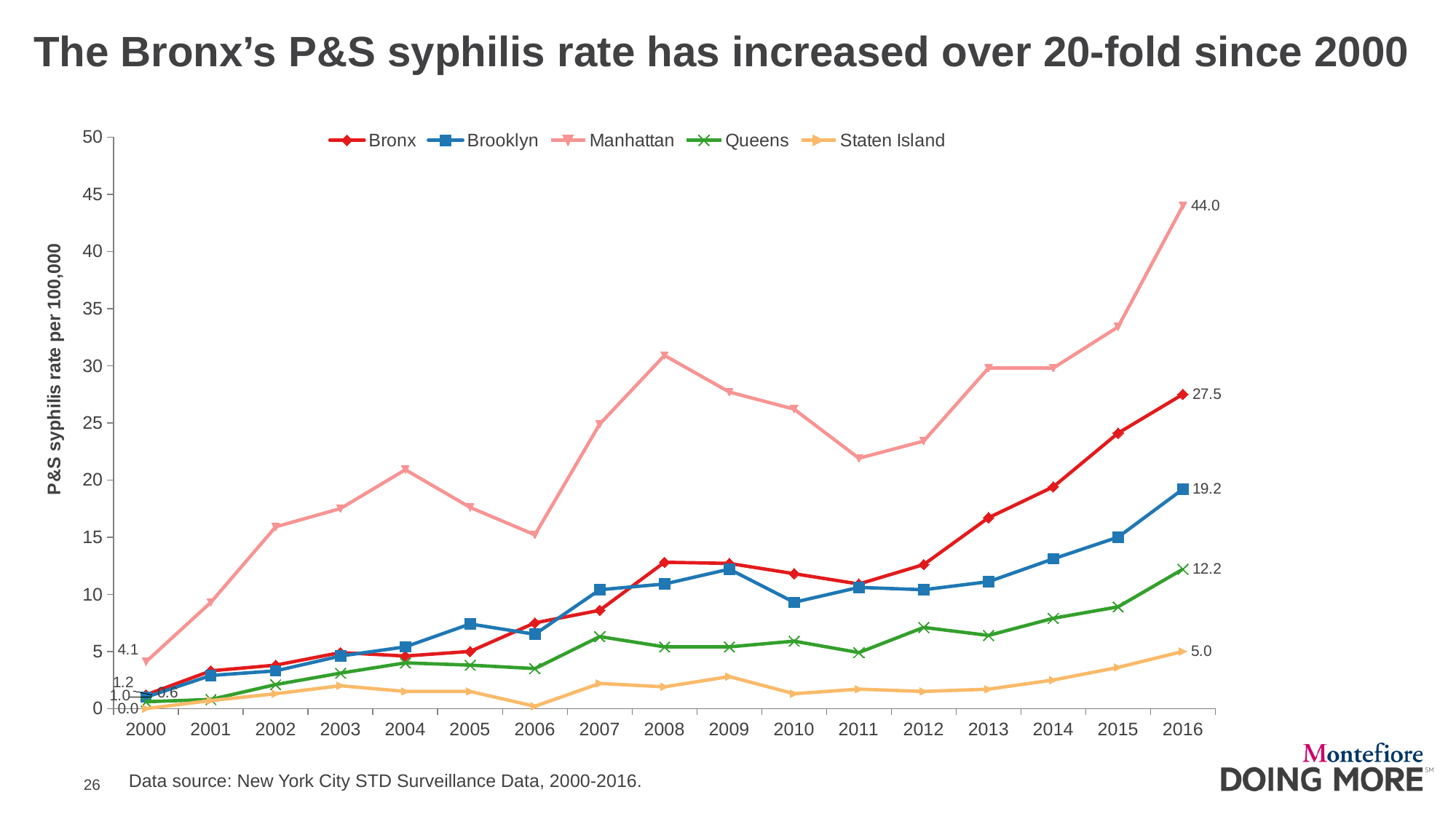
What is the P&S syphilis rate for the Bronx in 2016? 27.5 What is the P&S syphilis rate for Queens in 2016? 12.2 Is the Bronx's P&S syphilis rate in 2013 greater or less than 15? greater What kind of chart is shown on the slide? Line chart What is the difference between Manhattan's and the Bronx's P&S syphilis rates in 2016? 16.5 What is the P&S syphilis rate for Manhattan in 2016? 44.0 What is the P&S syphilis rate for Brooklyn in 2016? 19.2 Which borough has the highest P&S syphilis rate in 2016? Manhattan What is the P&S syphilis rate for Manhattan in 2000? 4.1 How many series does the legend list? 5 Which borough has the lowest P&S syphilis rate in 2016? Staten Island What is the P&S syphilis rate for Staten Island in 2016? 5.0